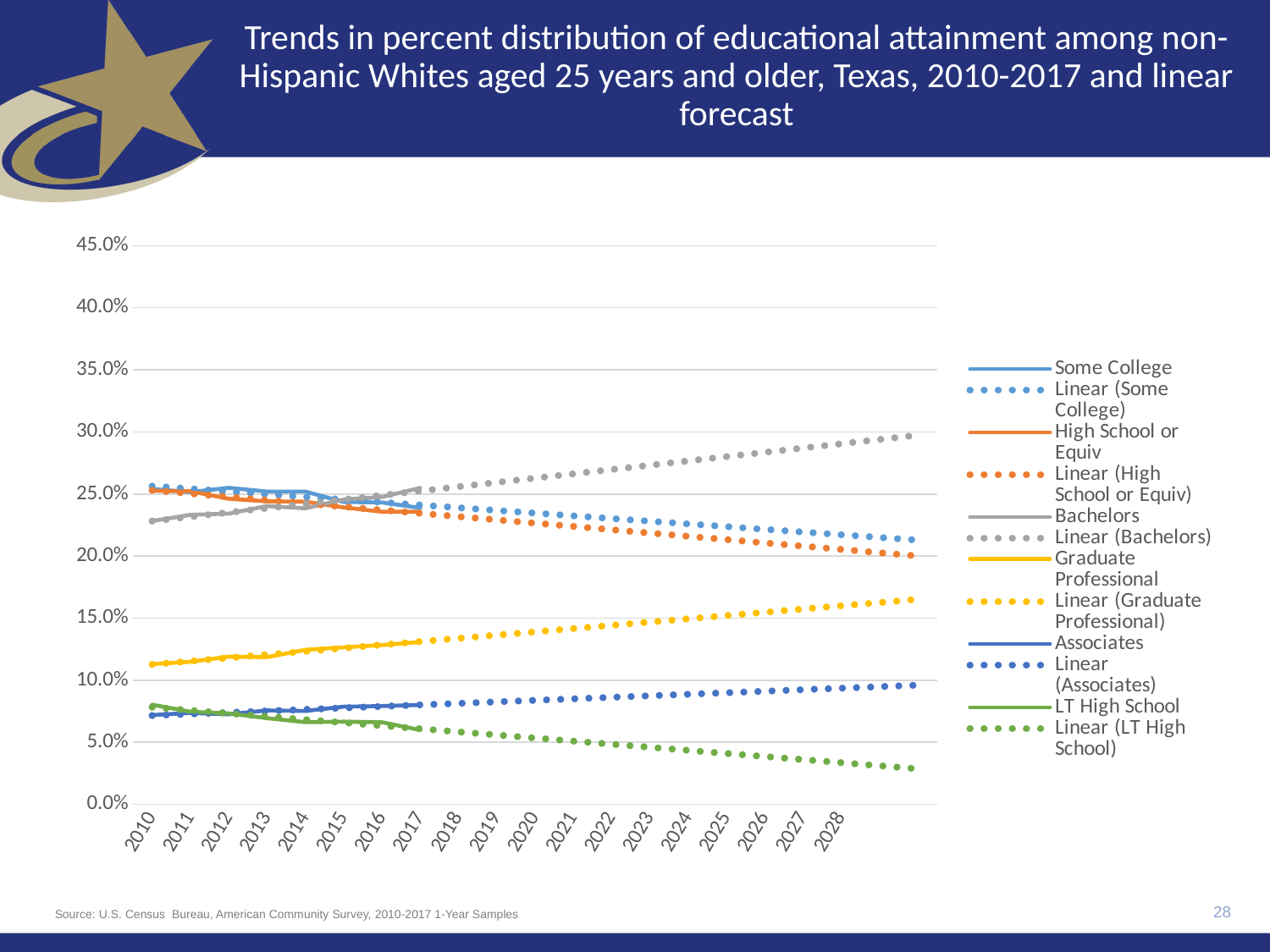
Is the Linear (Bachelors) forecast value for 2028 greater or less than 25.0%? greater Does the Bachelors series rise or fall from 2010 to 2017? rise Does the LT High School series rise or fall from 2010 to 2017? fall What kind of chart is shown on the slide? line chart Which linear forecast line has the highest value in 2028? Linear (Bachelors) In 2010, which is larger: the value for Bachelors or the value for Graduate Professional? Bachelors Is the value for Graduate Professional in 2010 greater or less than 15.0%? less Is the Linear (LT High School) forecast value for 2028 greater or less than 5.0%? less How many entries does the chart legend list? 12 Which linear forecast line has the lowest value in 2028? Linear (LT High School) How many years are labelled along the x axis of the chart? 19